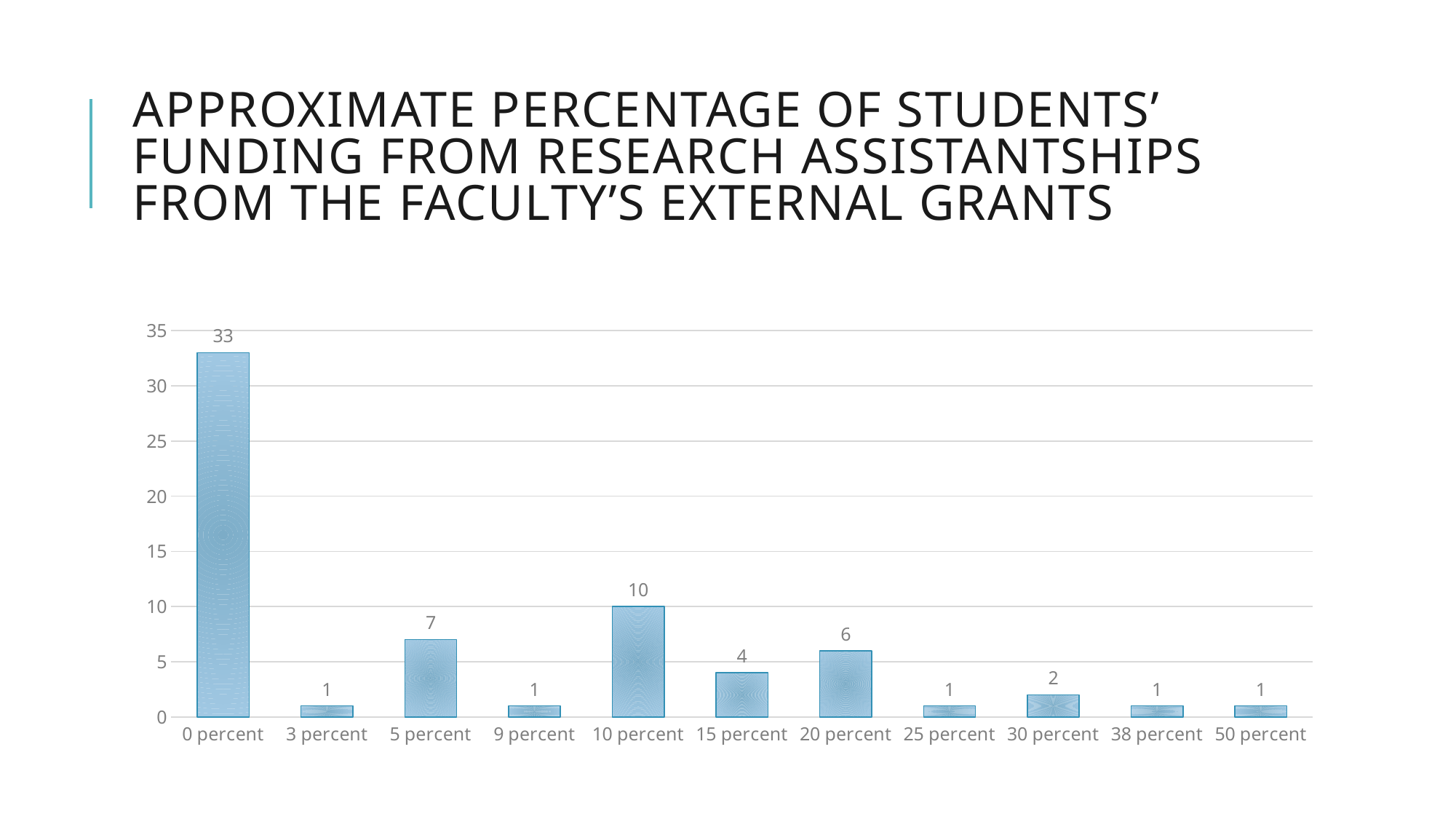
What is the value for the 30 percent category? 2 How many categories are shown on the x axis? 11 What is the value for the 10 percent category? 10 Which category has the highest value? 0 percent What kind of chart is shown on the slide? bar chart What is the title of the slide? Approximate percentage of students' funding from research assistantships from the faculty's external grants What is the difference between the values for 0 percent and 10 percent? 23 What is the difference between the values for 5 percent and 15 percent? 3 Is the value for 0 percent greater or less than 30? greater Which is larger, the value for 5 percent or the value for 20 percent? 5 percent What is the value for the 0 percent category? 33 What is the value for the 20 percent category? 6